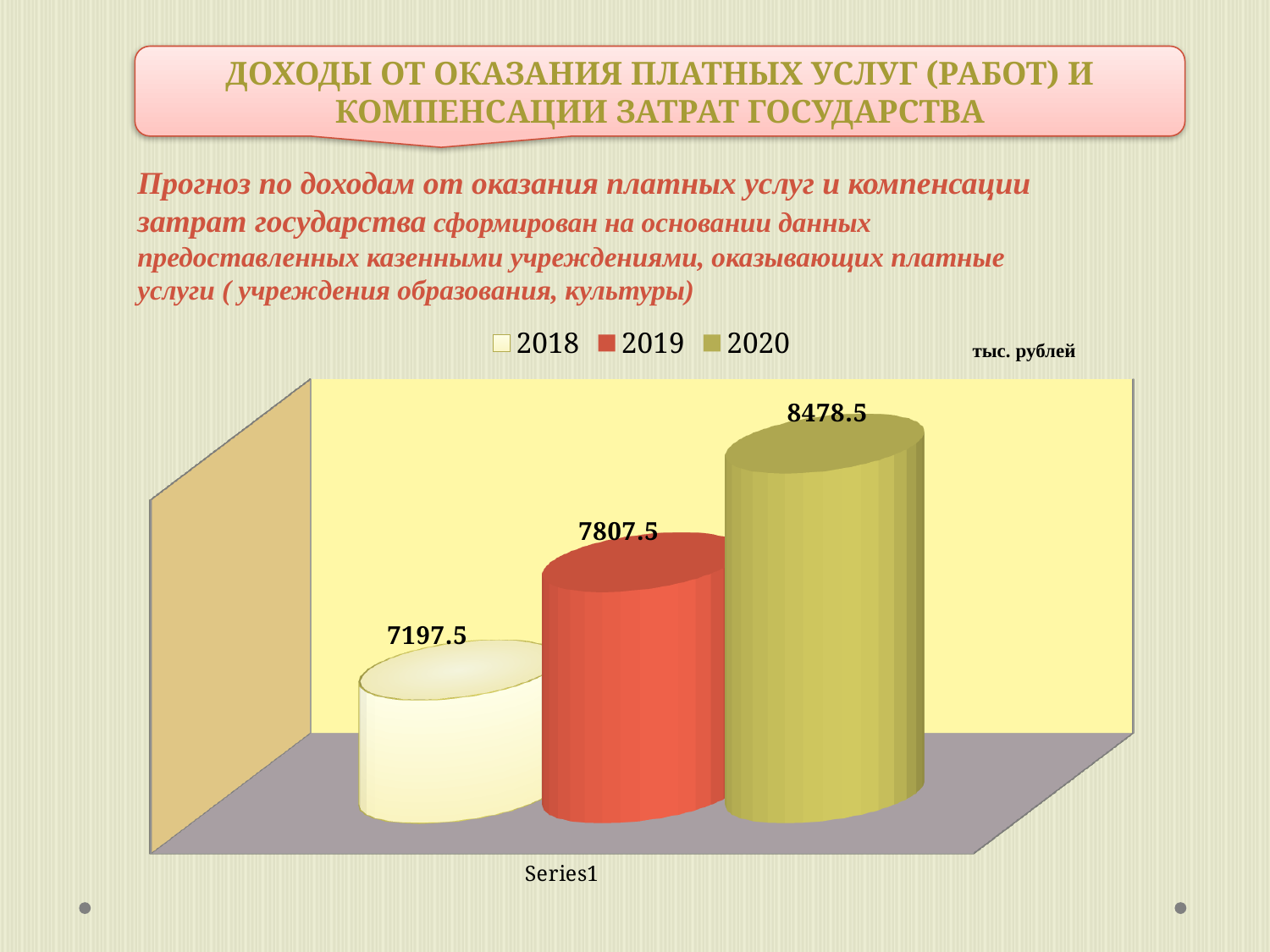
Which year has the lowest value? 2018 What kind of chart is shown on the slide? bar chart Do the values rise or fall from 2018 to 2020? rise Which year has the highest value? 2020 What is the difference between the values for 2020 and 2018? 1281 Which is larger, the value for 2019 or the value for 2020? 2020 What is the value for 2018? 7197.5 What is the difference between the values for 2019 and 2018? 610 What unit is indicated for the chart values? тыс. рублей How many series does the legend list? 3 What is the value for 2019? 7807.5 What is the value for 2020? 8478.5